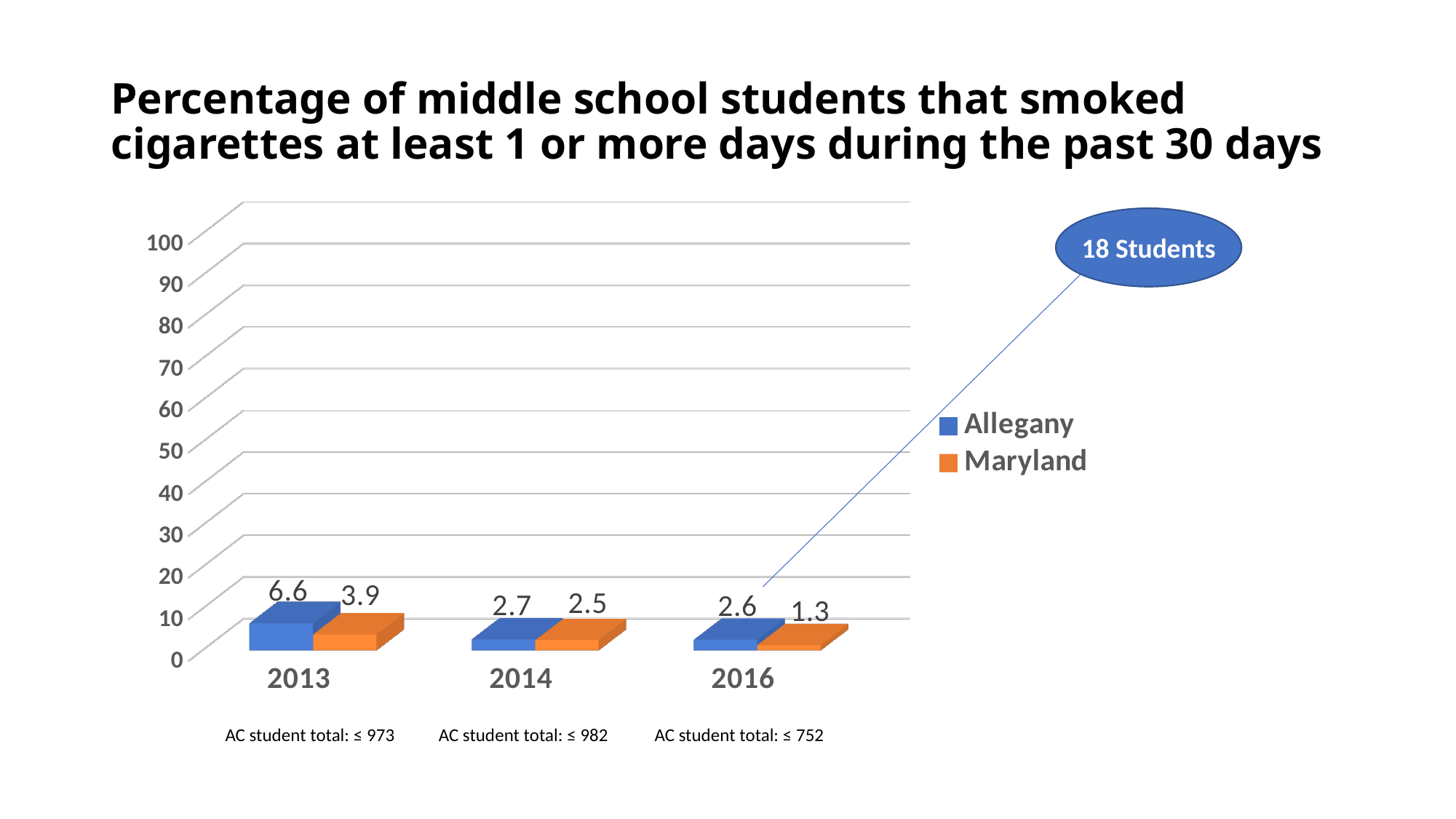
What is the difference between the Allegany values in 2013 and 2016? 4 Do the Maryland values rise or fall from 2013 to 2016? Fall How many series does the legend list? 2 Which is larger in 2016, the Allegany value or the Maryland value? Allegany In which year is the Maryland value lowest? 2016 What is the value for Maryland in 2016? 1.3 How many years are shown on the x axis? 3 In which year is the Allegany value highest? 2013 What kind of chart is shown on the slide? Bar chart What is the value for Allegany in 2013? 6.6 What is the difference between the Allegany and Maryland values in 2013? 2.7 What is the value for Maryland in 2014? 2.5